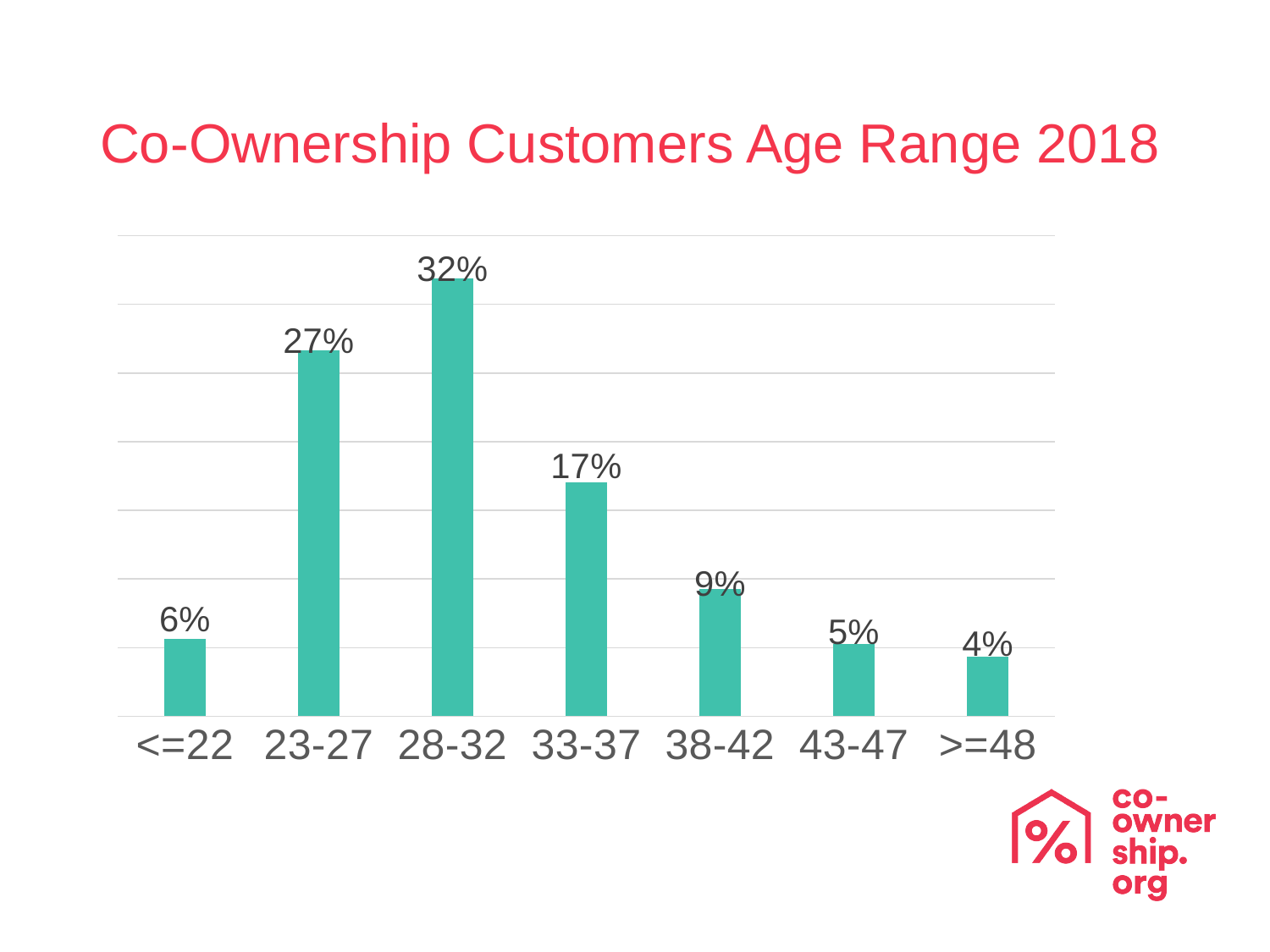
Which age range has the lowest share of customers? >=48 What is the title of the chart? Co-Ownership Customers Age Range 2018 What is the difference between the values for 33-37 and 43-47? 12% Which age range has the highest share of customers? 28-32 What percentage of co-ownership customers are in the 28-32 age range? 32% What is the difference between the values for 28-32 and 23-27? 5% Which is larger, the value for 23-27 or the value for 33-37? 23-27 What is the value for the <=22 age range? 6% How many age ranges are shown on the chart? 7 What kind of chart is shown on the slide? Bar chart What is the value for the 38-42 age range? 9% Do the values rise or fall from the 28-32 age range to the >=48 age range? Fall